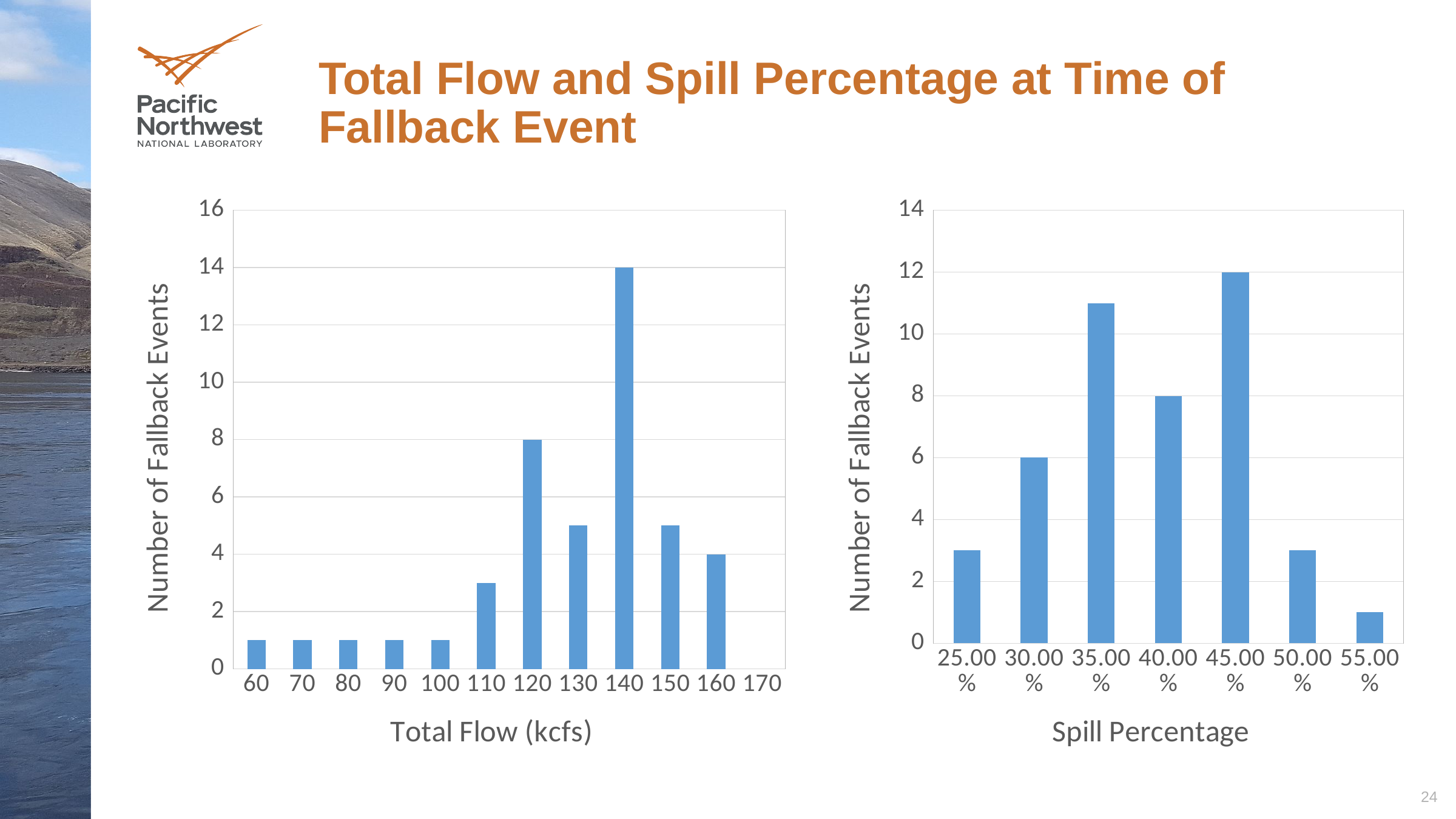
What type of chart is the Spill Percentage chart? bar chart On the Spill Percentage chart, is the number of fallback events at 35.00% spill greater or less than 10? greater On the Total Flow (kcfs) chart, how many fallback events occurred at a total flow of 120 kcfs? 8 On the Spill Percentage chart, how many fallback events occurred at 30.00% spill? 6 On the Spill Percentage chart, which spill percentage category has the lowest number of fallback events? 55.00% On the Total Flow (kcfs) chart, what is the difference in fallback events between the 140 kcfs and 120 kcfs categories? 6 On the Total Flow (kcfs) chart, how many fallback events occurred at a total flow of 140 kcfs? 14 On the Spill Percentage chart, which has more fallback events, 35.00% or 40.00% spill? 35.00% On the Total Flow (kcfs) chart, which total flow category has the highest number of fallback events? 140 On the Spill Percentage chart, how many fallback events occurred at 45.00% spill? 12 On the Total Flow (kcfs) chart, how many total flow categories are shown on the x axis? 12 On the Total Flow (kcfs) chart, is the number of fallback events at 130 kcfs greater or less than 4? greater